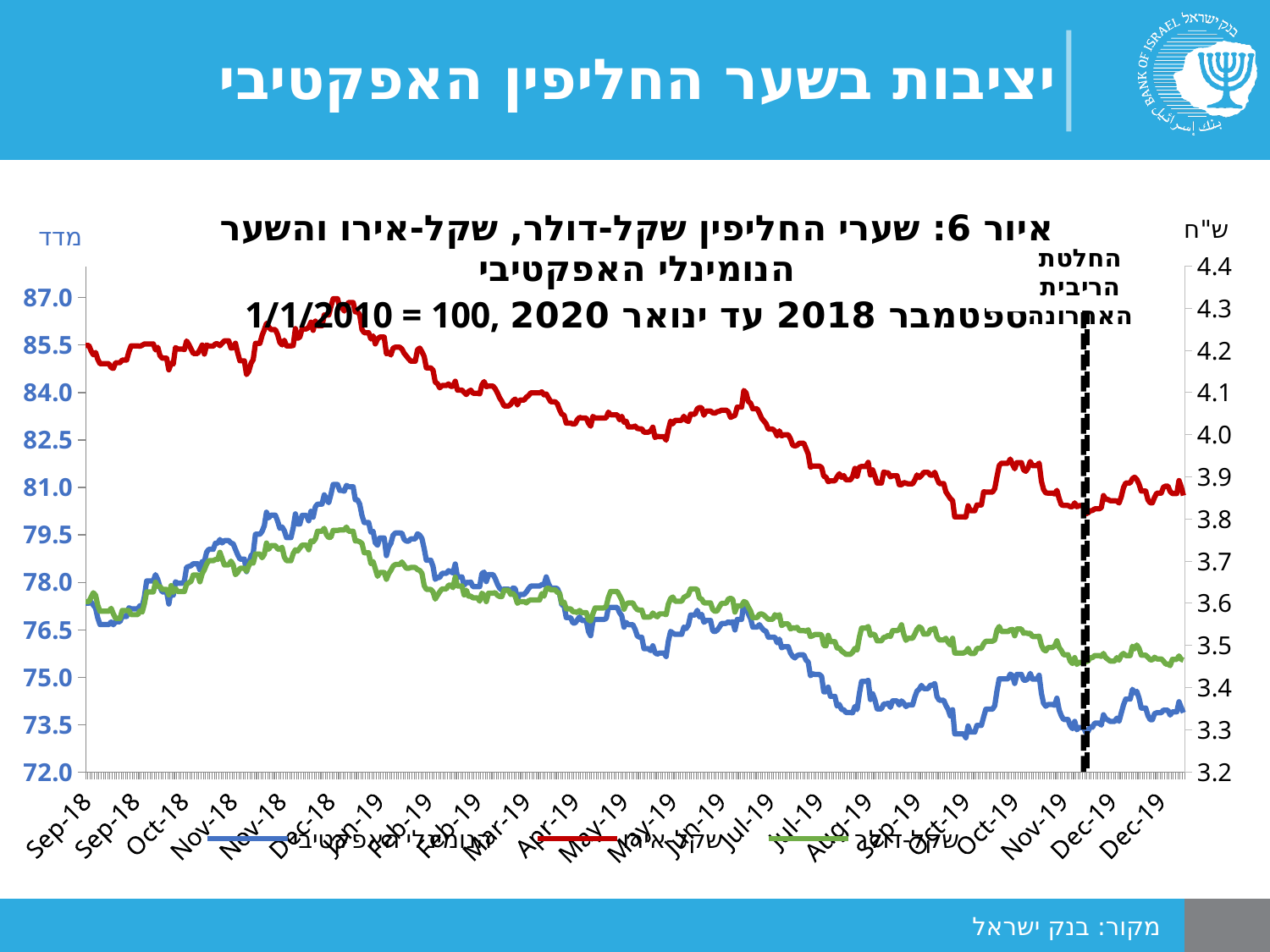
Which of the three lines reaches the highest position on the chart? the red shekel-euro line What does the vertical dashed black line near the right of the chart mark? החלטת הריבית האחרונה Is the peak of the blue line around Dec-18/Jan-19 greater or less than 79.5 on the left axis? greater What kind of chart is shown on the slide? line chart How many series does the legend list? 3 Is the value of the blue line at the end of the period (Dec-19) greater or less than 75.0 on the left axis? less What is the highest tick value shown on the right-hand axis? 4.4